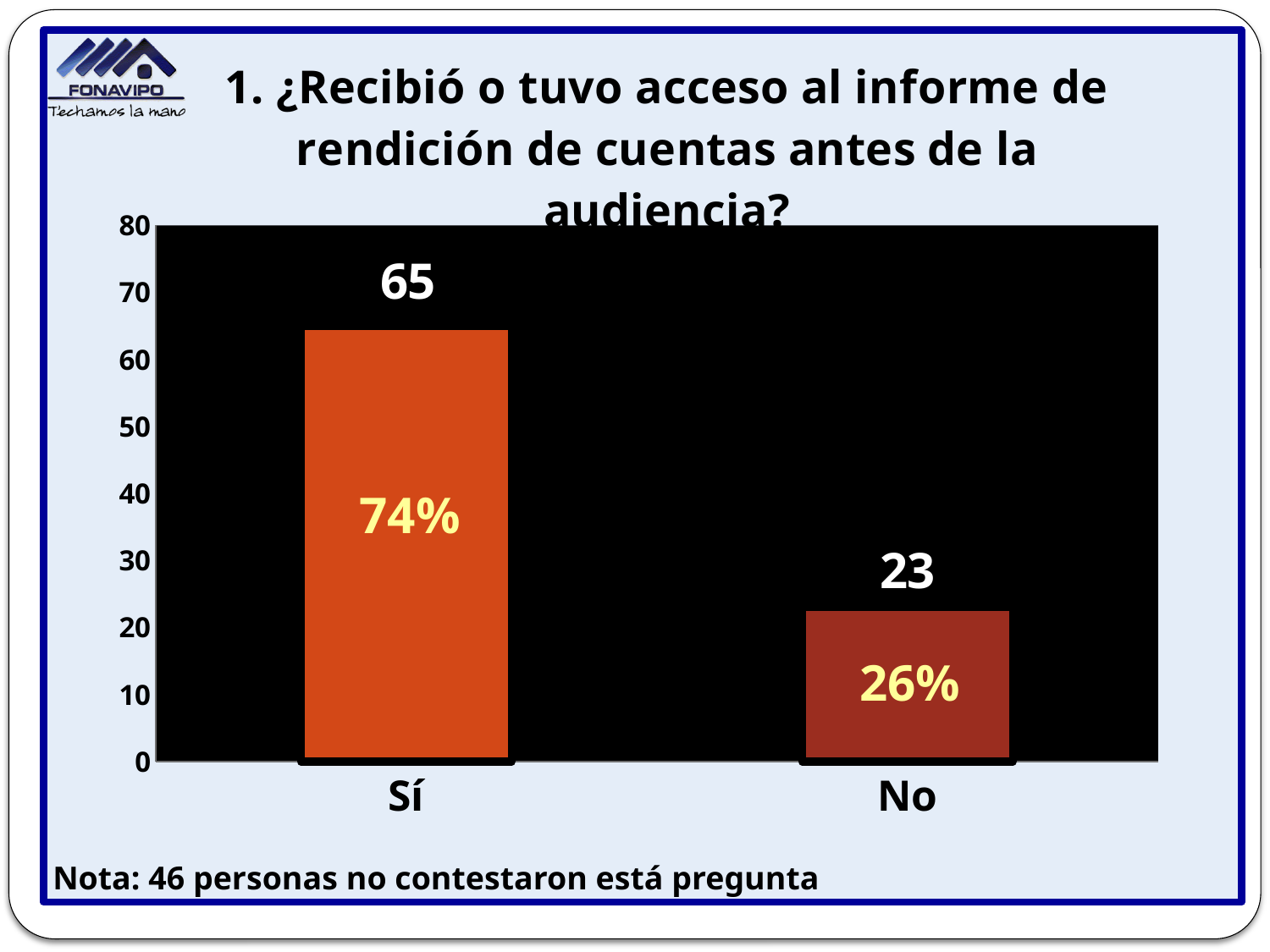
How many categories are shown on the x axis? 2 Is the value for "No" greater or less than 30? less Which is larger, the value for "Sí" or the value for "No"? Sí What percentage is shown inside the "Sí" bar? 74% What percentage is shown inside the "No" bar? 26% What is the value for "Sí"? 65 What is the value for "No"? 23 What is the difference between the values for "Sí" and "No"? 42 Which category has the highest value? Sí What is the maximum value shown on the y axis? 80 What kind of chart is shown on the slide? bar chart Which category has the lowest value? No